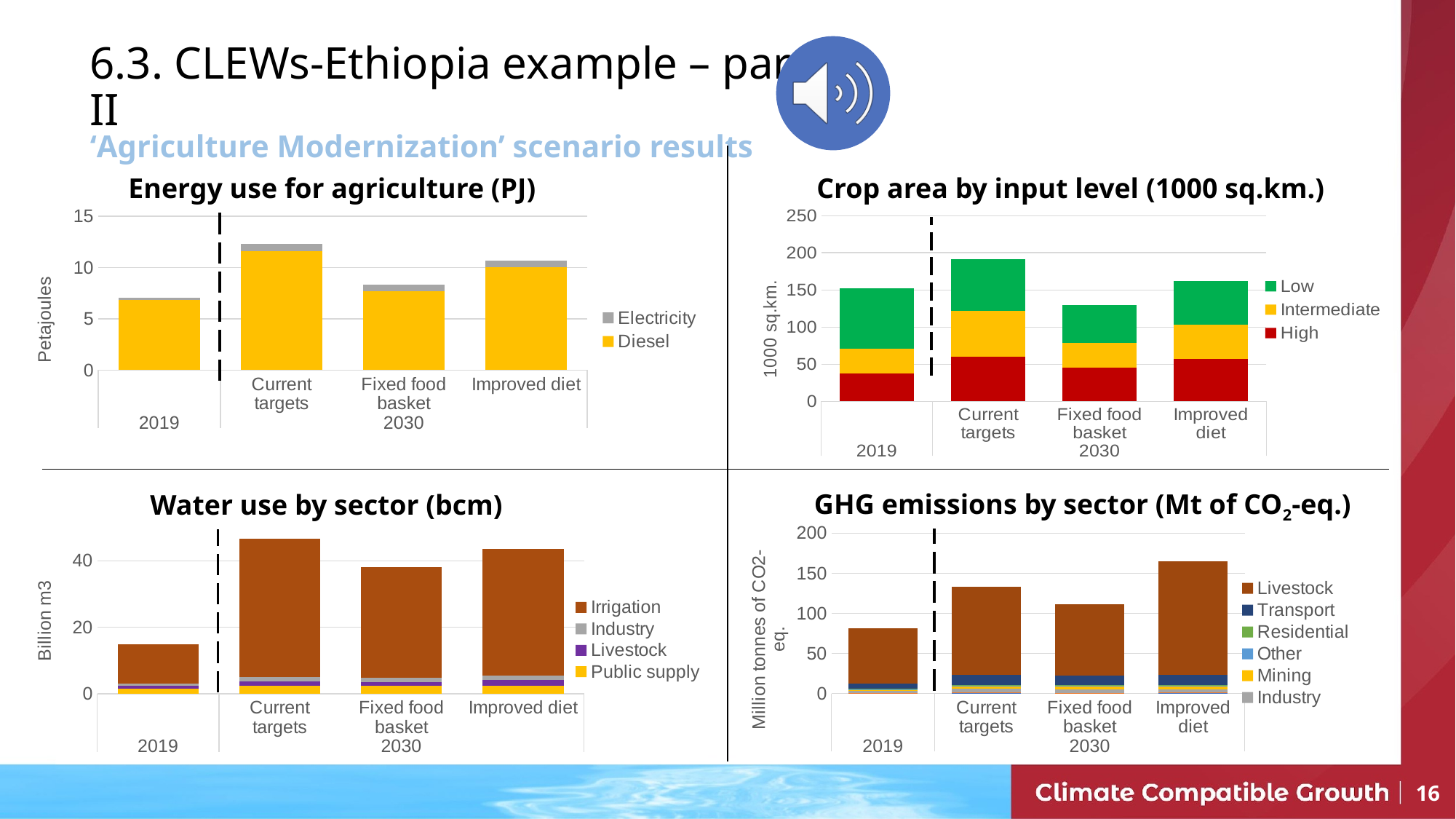
How many series does the legend of the 'GHG emissions by sector (Mt of CO2-eq.)' chart list? 6 How many series does the legend of the 'Crop area by input level (1000 sq.km.)' chart list? 3 How many series does the legend of the 'Energy use for agriculture (PJ)' chart list? 2 In the 'Energy use for agriculture (PJ)' chart, which scenario has the highest total energy use? Current targets In the 'Energy use for agriculture (PJ)' chart, is the total for Current targets greater or less than 10? greater In the 'Water use by sector (bcm)' chart, is the total for 2019 greater or less than 20? less In the 'Water use by sector (bcm)' chart, which bar has the lowest total water use? 2019 In the 'Crop area by input level (1000 sq.km.)' chart, is the total for Current targets greater or less than 150? greater In the 'GHG emissions by sector (Mt of CO2-eq.)' chart, which scenario has the highest total emissions? Improved diet In the 'Crop area by input level (1000 sq.km.)' chart, which bar has the lowest total crop area? Fixed food basket In the 'Water use by sector (bcm)' chart, which sector accounts for the largest part of each bar? Irrigation